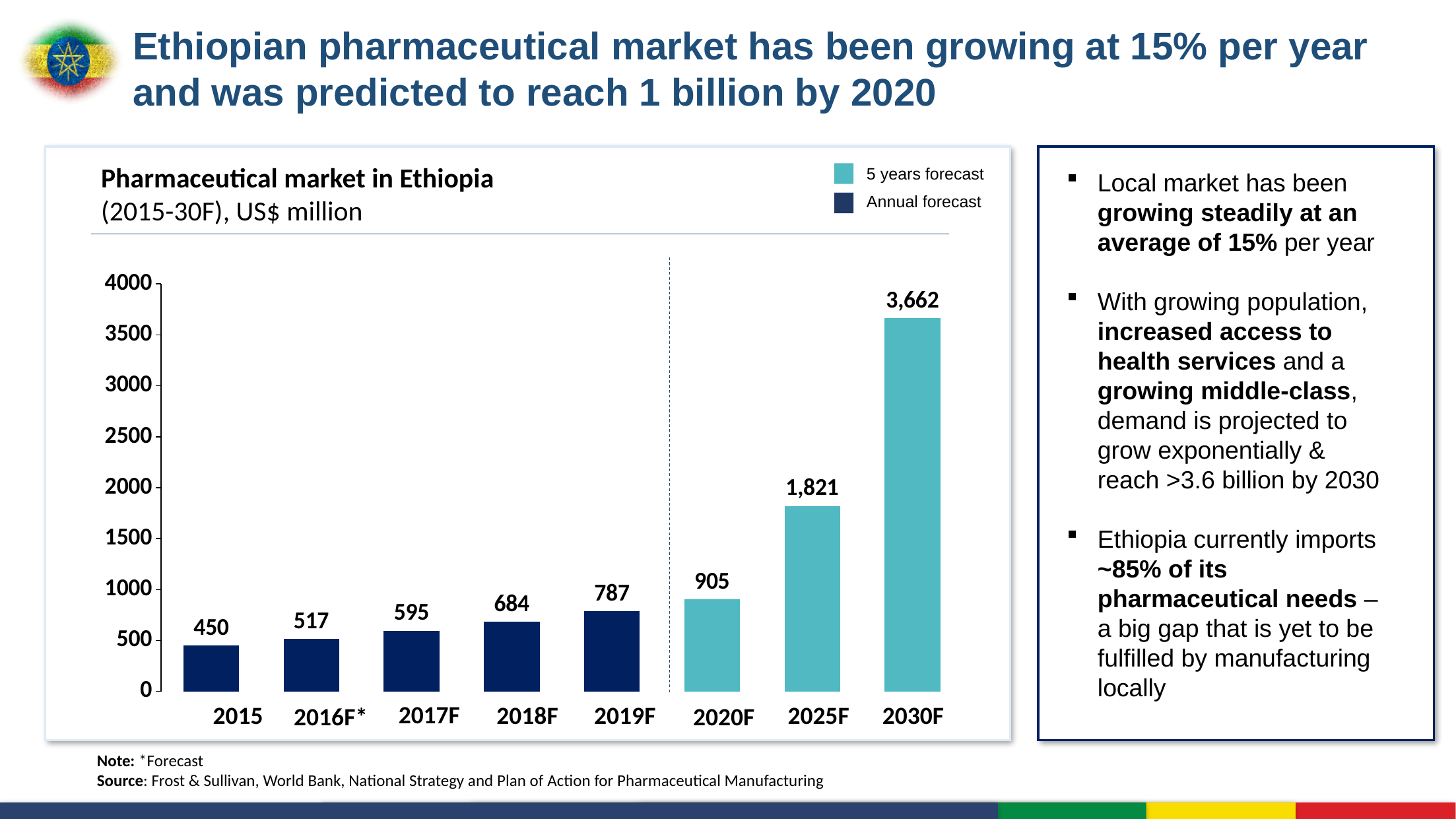
How many years are shown on the x axis? 8 Is the value for 2020F greater or less than 1000? less What kind of chart is shown? bar chart What is the value for 2030F? 3,662 How many series does the legend list? 2 Which year has the highest value? 2030F Which year has the lowest value? 2015 Which is larger, the value for 2018F or the value for 2017F? 2018F What is the value for 2015? 450 What is the difference between the values for 2025F and 2020F? 916 What is the value for 2019F? 787 Do the values rise or fall from 2015 to 2030F? rise